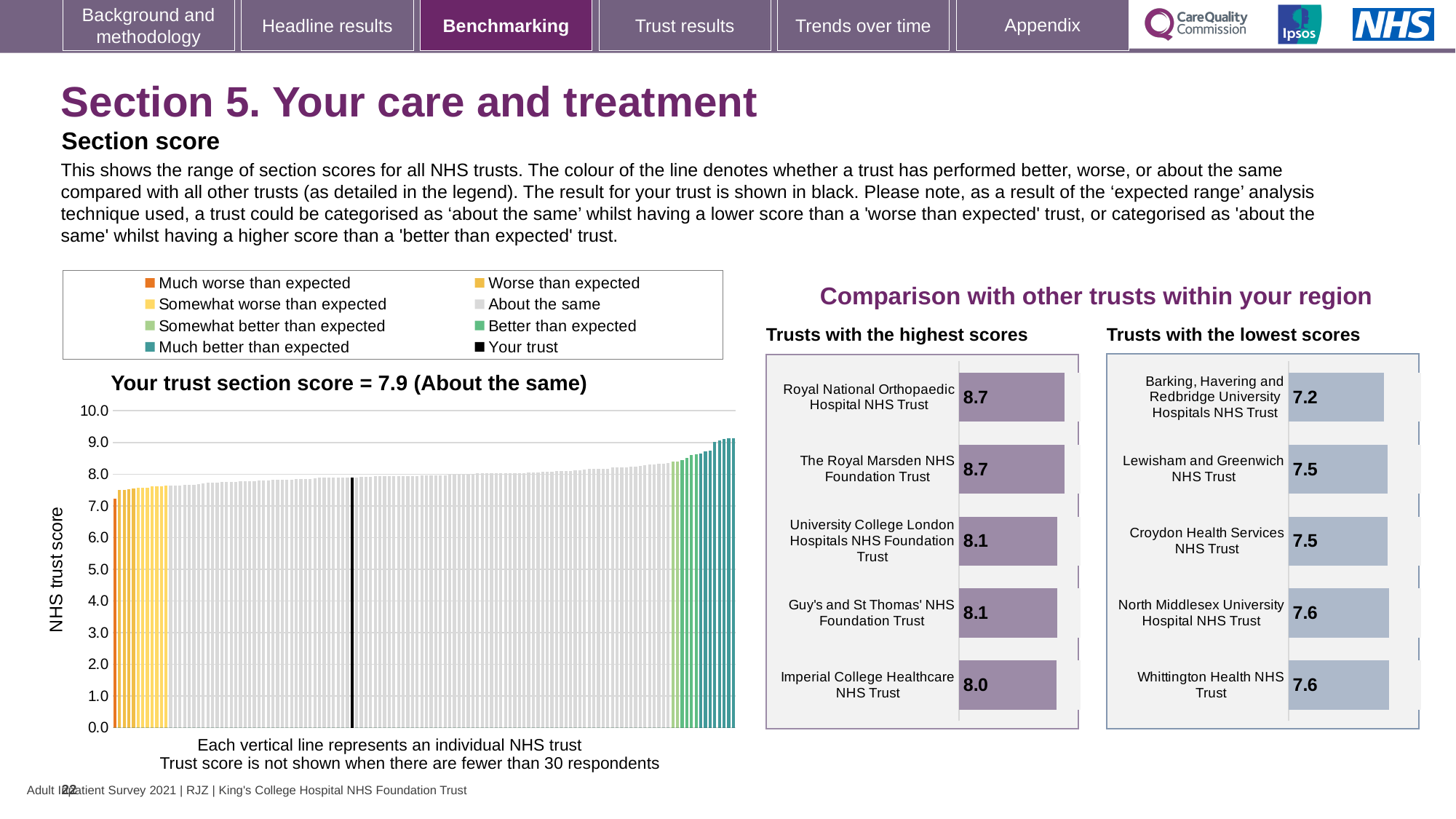
In the 'Your trust section score' chart, what is the section score for your trust? 7.9 In the 'Trusts with the lowest scores' chart, which trust has the lowest score? Barking, Havering and Redbridge University Hospitals NHS Trust What is the y-axis label of the 'Your trust section score' chart? NHS trust score How many entries does the legend above the 'Your trust section score' chart list? 8 In the 'Trusts with the highest scores' chart, how many trusts are shown? 5 In the 'Trusts with the lowest scores' chart, what is the score for Croydon Health Services NHS Trust? 7.5 In the 'Trusts with the highest scores' chart, what is the score for Imperial College Healthcare NHS Trust? 8.0 In the 'Trusts with the highest scores' chart, what is the difference between the scores of Royal National Orthopaedic Hospital NHS Trust and Imperial College Healthcare NHS Trust? 0.7 In the 'Trusts with the highest scores' chart, which has the higher score: The Royal Marsden NHS Foundation Trust or Guy's and St Thomas' NHS Foundation Trust? The Royal Marsden NHS Foundation Trust In the 'Trusts with the highest scores' chart, which trust has the lowest score? Imperial College Healthcare NHS Trust What kind of chart is the 'Your trust section score' chart? bar chart In the 'Your trust section score' chart, is the value of the lowest bar greater or less than 8.0? less